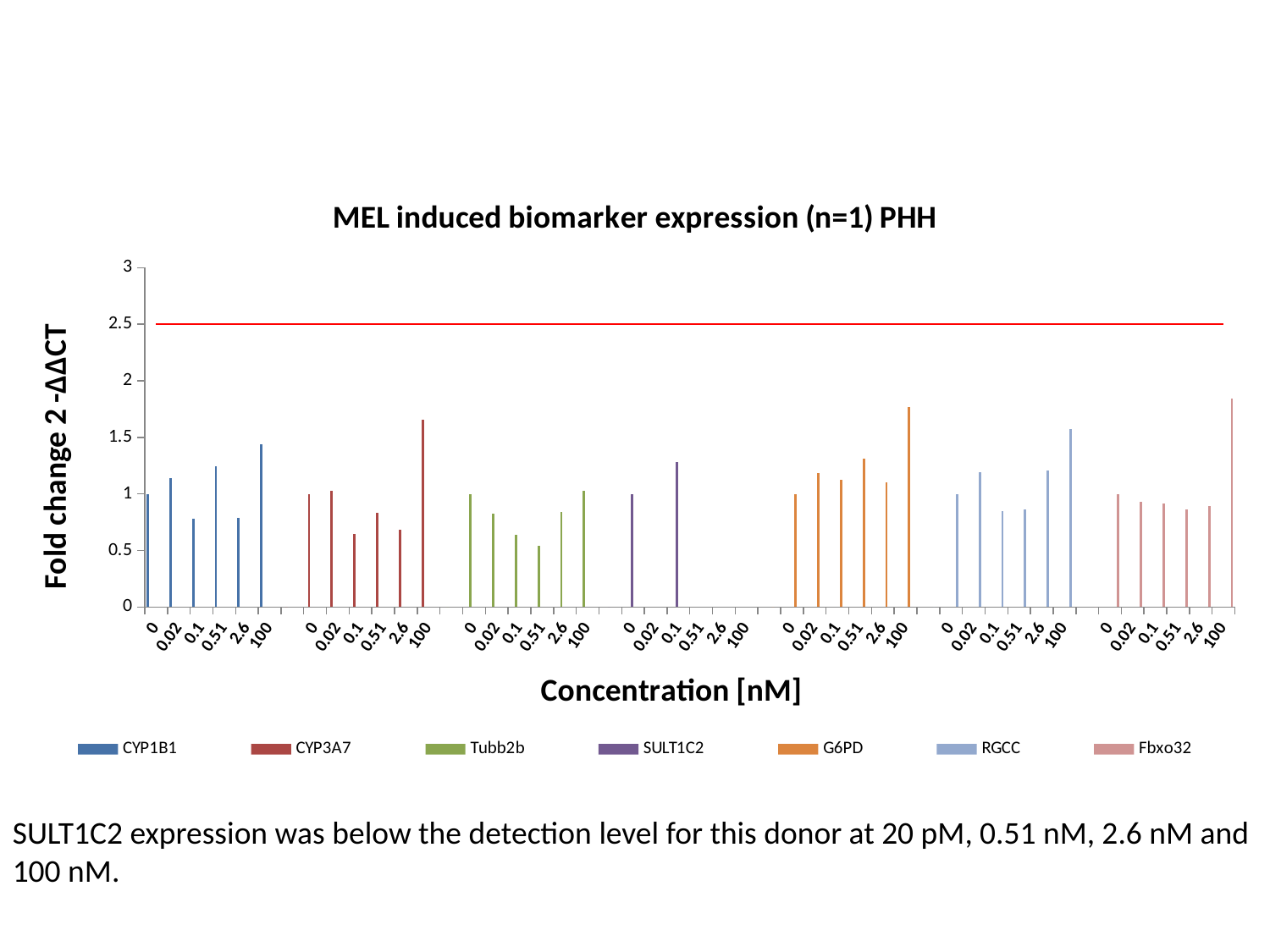
Is the value for CYP3A7 at 100 nM greater or less than 1.5? greater What kind of chart is shown on the slide? bar chart Is the value for SULT1C2 at 0.1 nM greater or less than 1? greater What is the title of the chart? MEL induced biomarker expression (n=1) PHH At which concentration is the G6PD fold change highest? 100 At which y-axis value is the horizontal red line drawn? 2.5 Is the value for CYP1B1 at 0.1 nM greater or less than 1? less How many concentration levels are shown on the x axis for each gene? 6 At which concentration is the Fbxo32 fold change highest? 100 How many series does the legend list? 7 Which is larger at 100 nM: the value for G6PD or the value for CYP1B1? G6PD